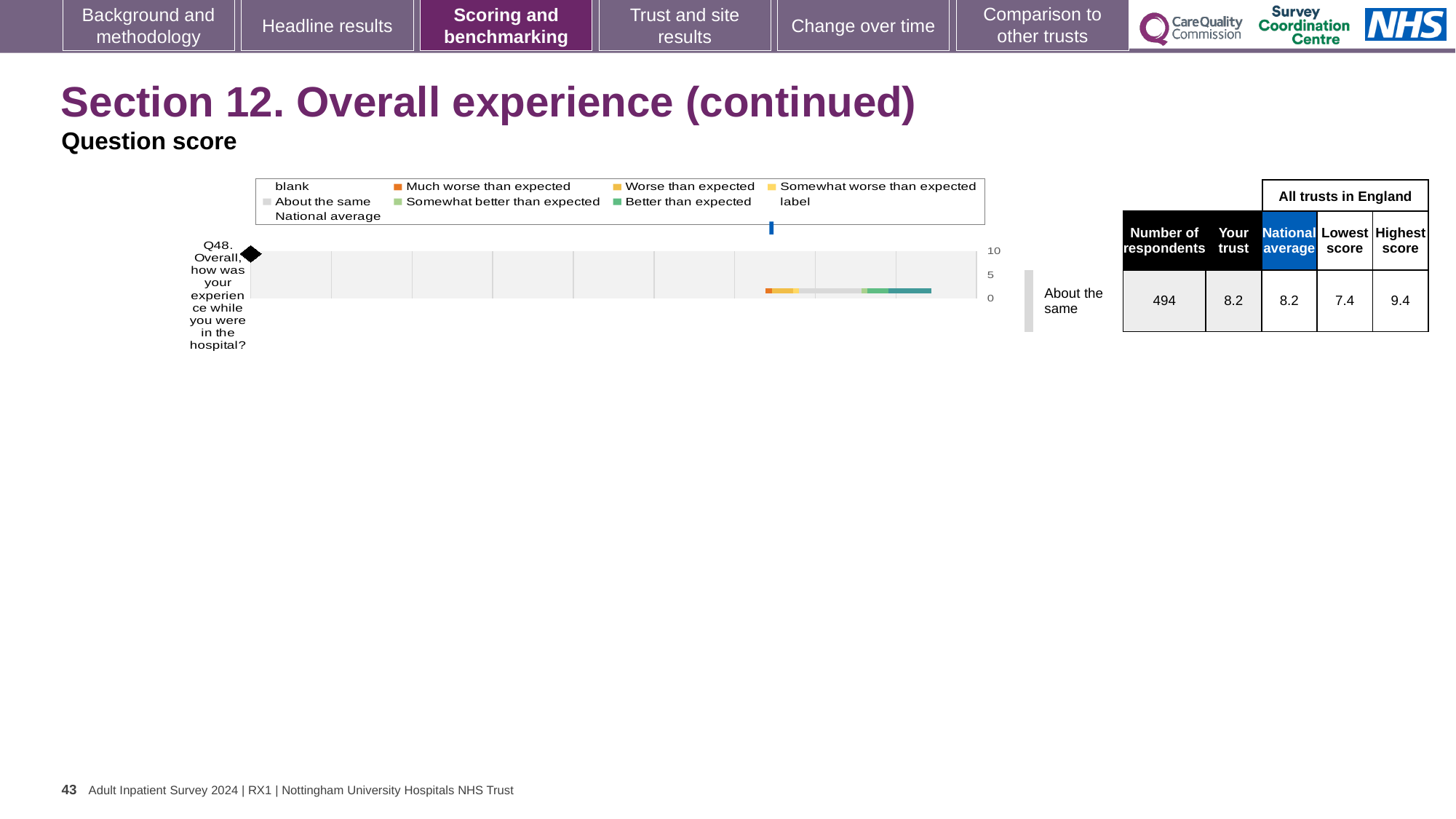
What is the difference between the highest score and the lowest score for Q48? 2.0 What is the number of respondents for Q48 in the table beside the chart? 494 What is the lowest score among all trusts in England for Q48? 7.4 How is the trust's result for Q48 categorised next to the chart? About the same What kind of chart is used to show the Q48 question score? bar chart What is the national average score for Q48 in the table beside the chart? 8.2 How many questions are plotted in the chart? 1 Which legend entry is shown in orange? Much worse than expected What is the 'Your trust' score for Q48 in the table beside the chart? 8.2 What is the highest score among all trusts in England for Q48? 9.4 Which question is plotted in the chart? Q48. Overall, how was your experience while you were in the hospital? Which is larger for Q48, the lowest score or the highest score? Highest score